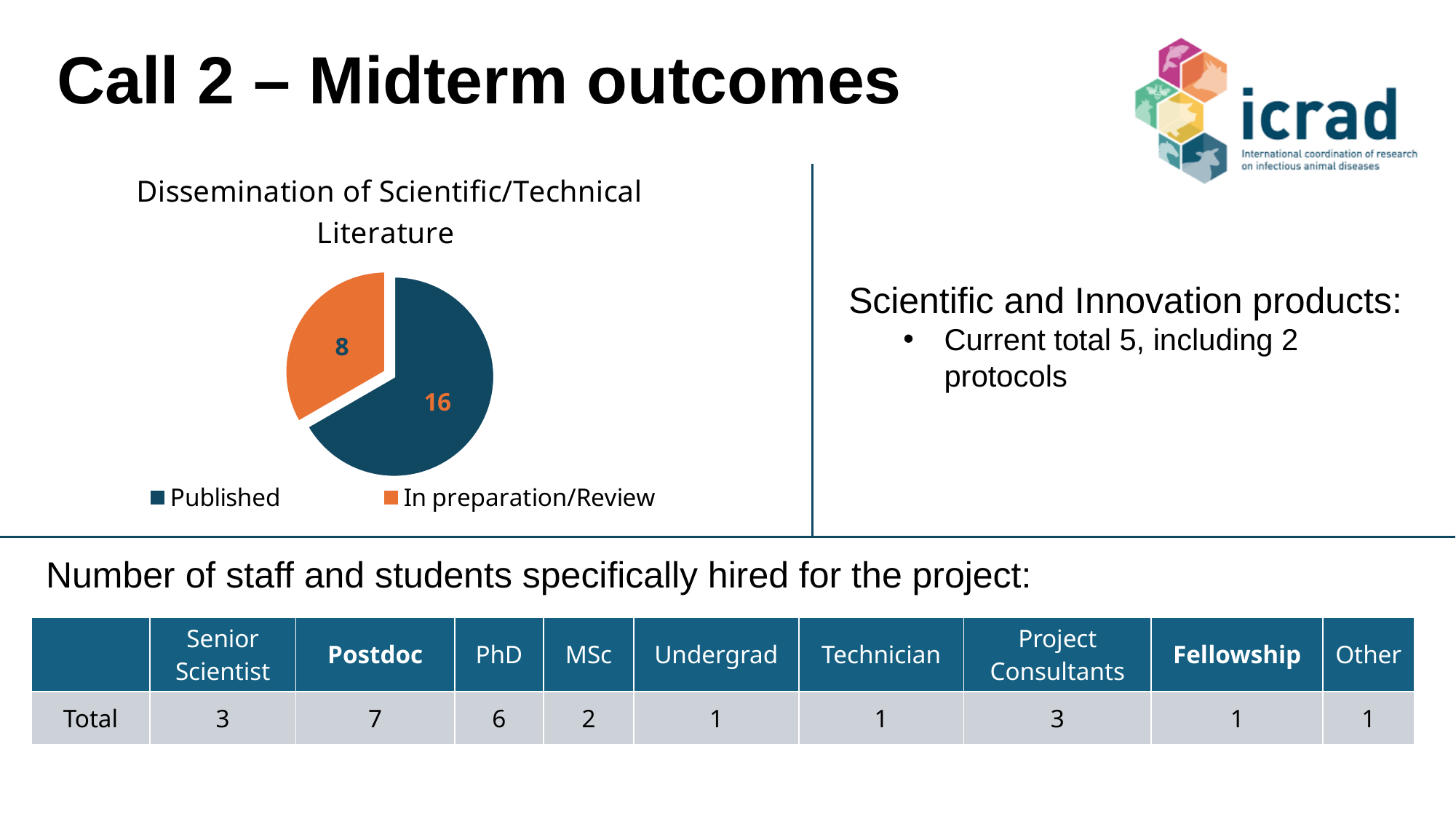
What is the total of the two values shown in the pie chart? 24 What colour is the Published slice in the pie chart? Dark blue What is the difference between the Published and In preparation/Review values in the pie chart? 8 What is the value for Published in the pie chart? 16 What is the value for In preparation/Review in the pie chart? 8 Which category has the smallest slice in the pie chart? In preparation/Review How many entries does the legend of the pie chart list? 2 Which is larger in the pie chart, Published or In preparation/Review? Published What is the title of the pie chart? Dissemination of Scientific/Technical Literature How many slices does the pie chart have? 2 Which category has the largest slice in the pie chart? Published What kind of chart is shown on the slide? Pie chart